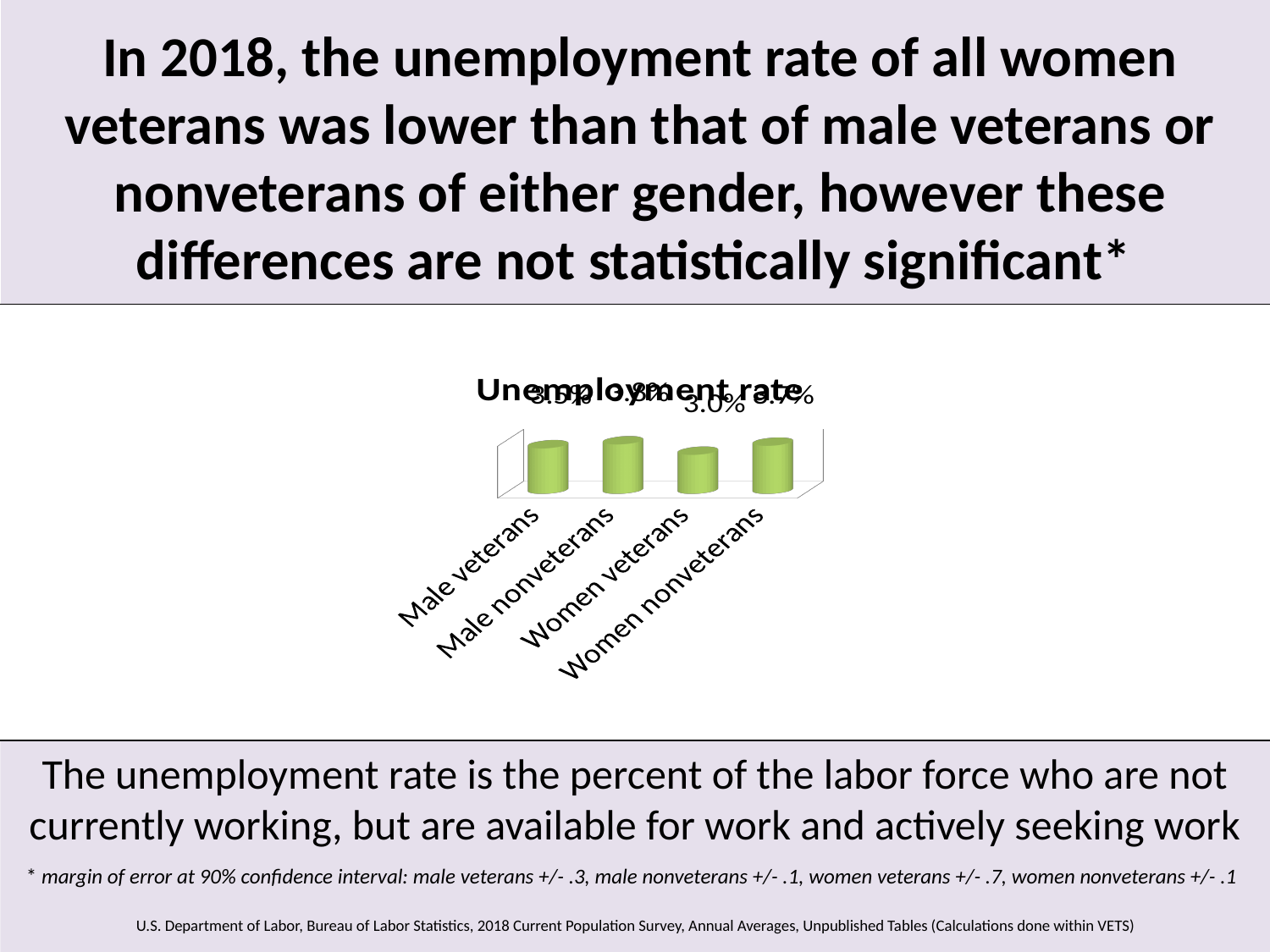
How many categories are shown in the chart? 4 Which has a higher unemployment rate, Women veterans or Women nonveterans? Women nonveterans What colour are the bars in the chart? Green What is the unemployment rate for Women veterans? 3.0% Which has a higher unemployment rate, Male veterans or Women veterans? Male veterans What is the unemployment rate for Women nonveterans? 3.7% Which category has the lowest unemployment rate? Women veterans What is the title of the chart? Unemployment rate What kind of chart is shown on the slide? Bar chart What is the difference between the unemployment rates of Women nonveterans and Women veterans? 0.7%